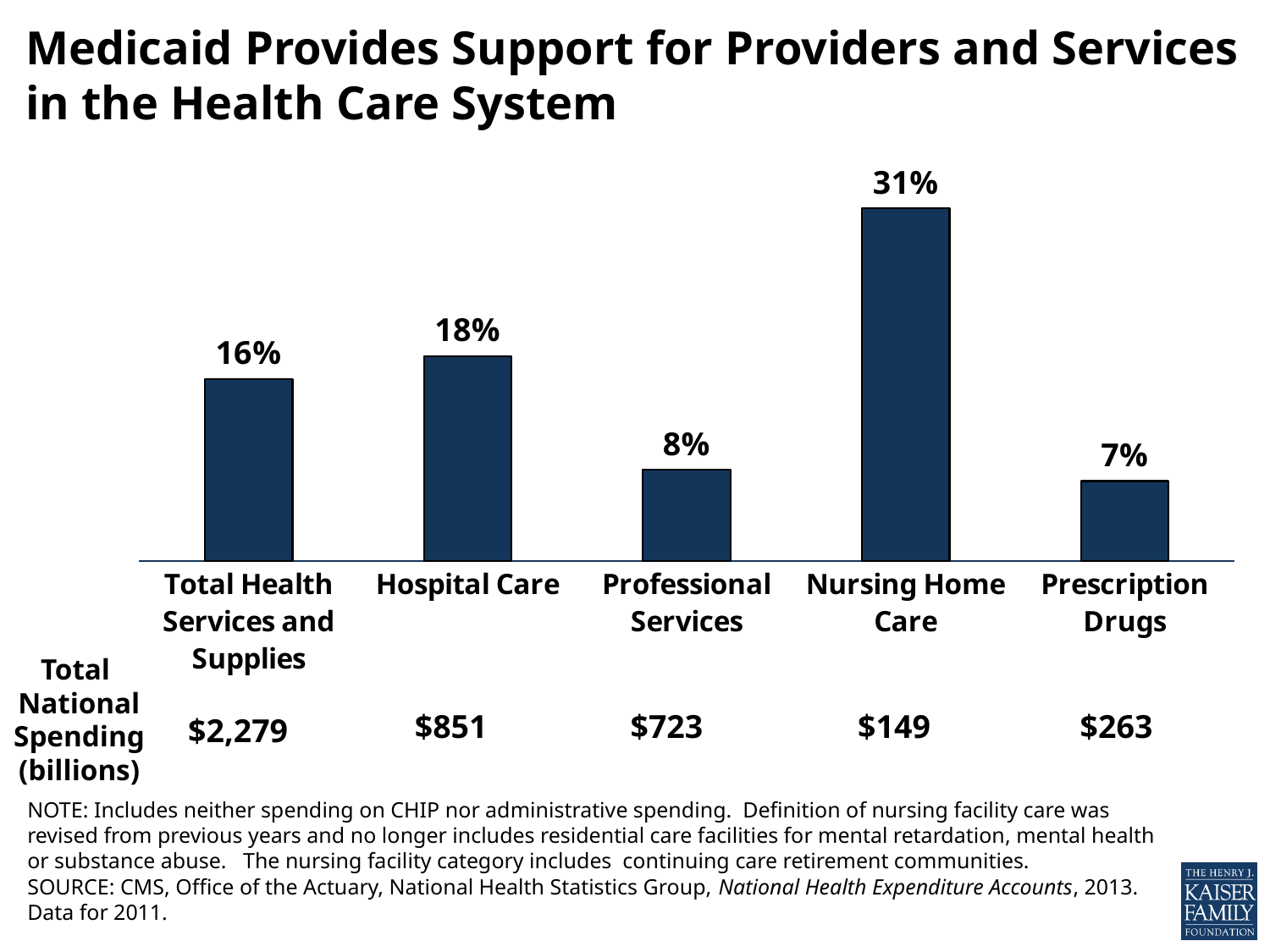
What is the difference in percentage points between Total Health Services and Supplies and Professional Services? 8 How many categories are shown in the chart? 5 What is the total national spending (billions) shown for Professional Services? $723 Which category has the lowest percentage bar? Prescription Drugs What percentage is shown for Prescription Drugs? 7% Which has a larger percentage, Hospital Care or Total Health Services and Supplies? Hospital Care What is the total national spending (billions) shown for Total Health Services and Supplies? $2,279 What percentage is shown for Hospital Care? 18% What is the difference in percentage points between Nursing Home Care and Hospital Care? 13 What kind of chart is shown on the slide? Bar chart Which category has the highest percentage bar? Nursing Home Care What percentage is shown for Nursing Home Care? 31%